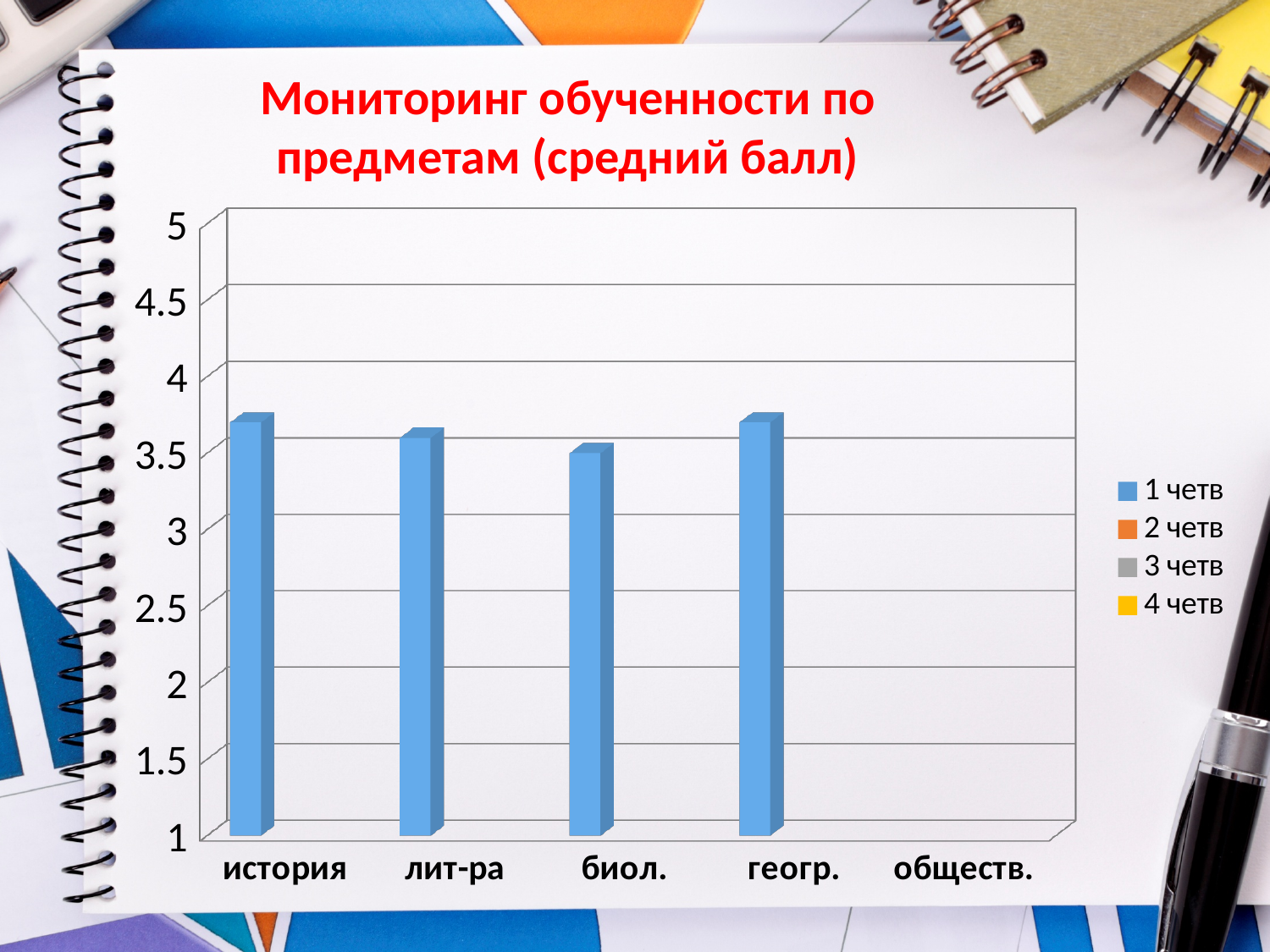
What is the title of the chart? Мониторинг обученности по предметам (средний балл) Is the value for история greater or less than 3.5? greater Is the value for история greater or less than 4? less Is the value for биол. greater or less than 3? greater Which legend entry do the blue bars correspond to? 1 четв Which is larger, the value for история or the value for биол.? история Which is larger, the value for геогр. or the value for биол.? геогр. How many categories are shown on the x axis of the chart? 5 How many series does the chart's legend list? 4 What kind of chart is shown on the slide? bar chart